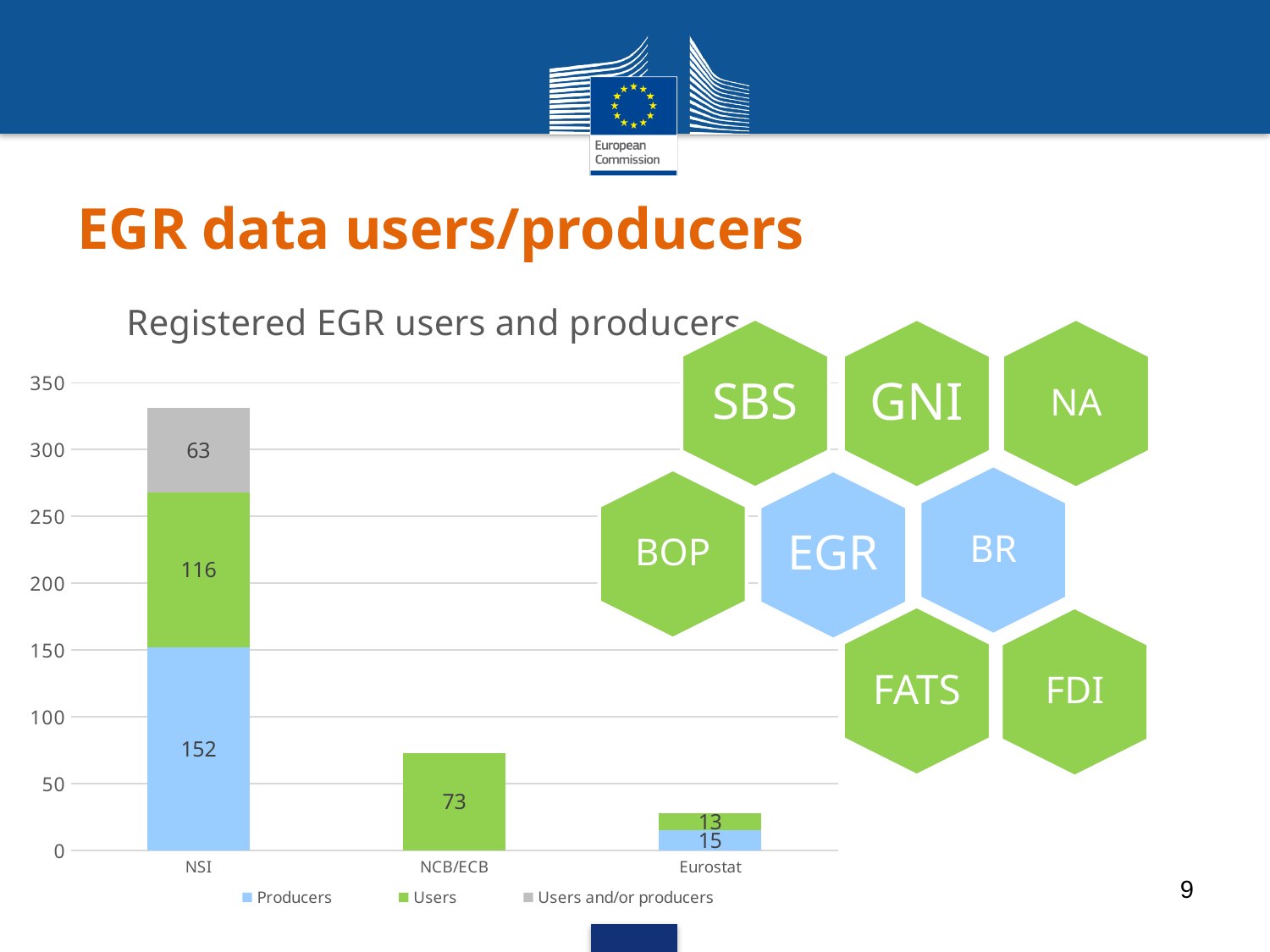
How many series does the legend list? 3 What is the Producers value for Eurostat? 15 Which category has the tallest stacked bar? NSI What is the difference between the Users value for NSI and the Users value for NCB/ECB? 43 What is the Users and/or producers value for NSI? 63 What is the Producers value for NSI in the Registered EGR users and producers chart? 152 Which is larger for Eurostat, the Producers value or the Users value? Producers What type of chart is shown on the slide? Stacked bar chart What is the total of the stacked bar for Eurostat? 28 What is the total of the stacked bar for NSI? 331 What is the Users value for NCB/ECB? 73 Which category has the shortest stacked bar? Eurostat